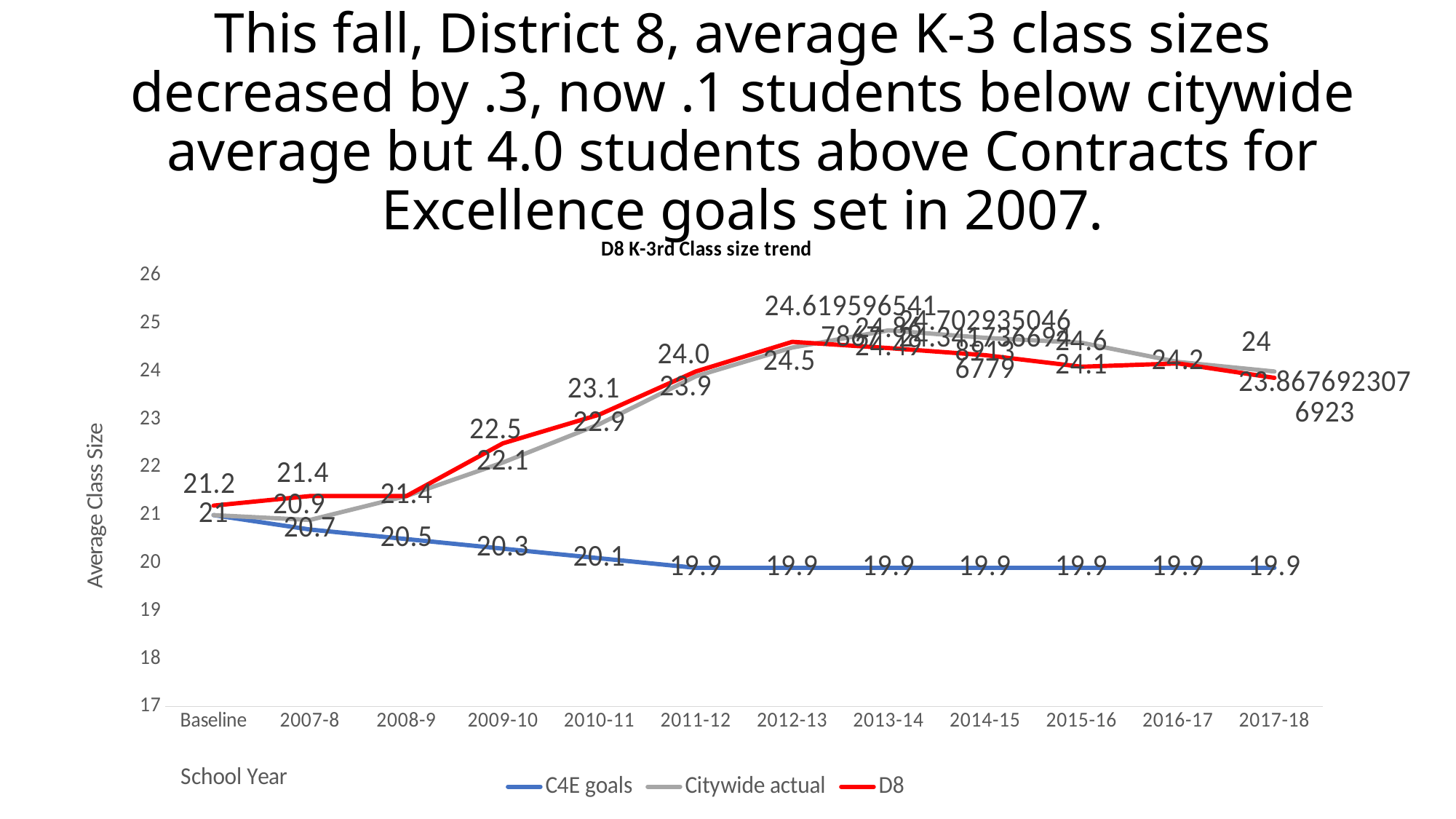
What is the difference between the D8 value and the C4E goals value in 2011-12? 4.1 What is the D8 value at Baseline? 21.2 What is the C4E goals value for 2017-18? 19.9 Is the D8 value for 2012-13 greater or less than 24? greater How many school years are shown on the x axis? 12 What kind of chart is shown on the slide? line chart What is the title of the chart? D8 K-3rd Class size trend Do the C4E goals values rise or fall from Baseline to 2011-12? fall In 2010-11, which is larger, the D8 value or the Citywide actual value? D8 How many series does the legend list? 3 What is the Citywide actual value for 2012-13? 24.5 What is the D8 value for 2011-12? 24.0